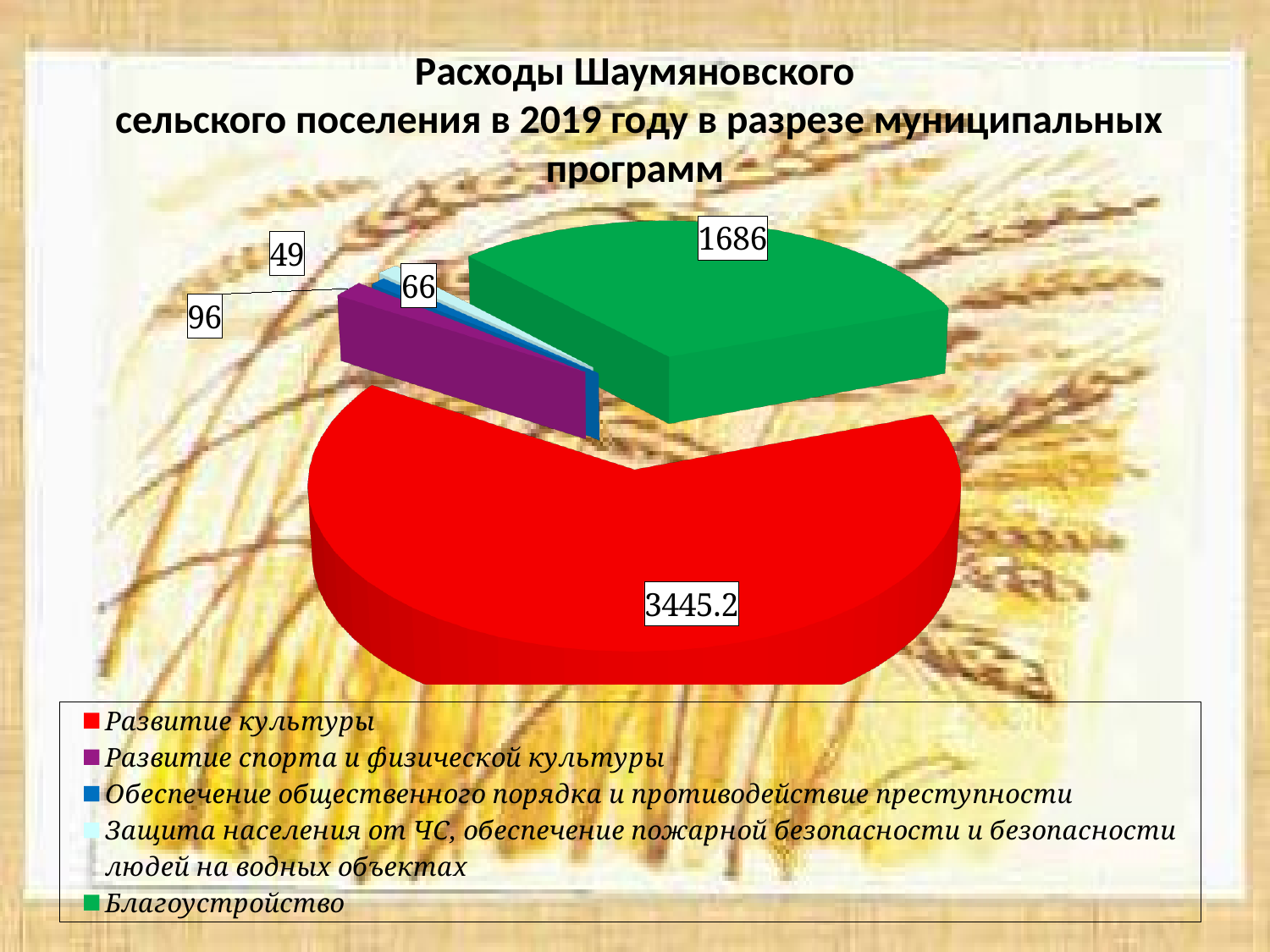
Which is larger, the value for Благоустройство or the value for Развитие спорта и физической культуры? Благоустройство What is the value for Благоустройство? 1686 What is the difference between the values for Развитие культуры and Благоустройство? 1759.2 How many slices does the pie chart have? 5 What colour is the slice for Благоустройство? green What kind of chart is shown on the slide? pie chart Which category has the largest slice of the pie? Развитие культуры What is the difference between the values for Благоустройство and Развитие спорта и физической культуры? 1590 What is the title of the chart? Расходы Шаумяновского сельского поселения в 2019 году в разрезе муниципальных программ What is the smallest value labelled on the chart? 49 What is the value for Развитие культуры? 3445.2 What is the value for Развитие спорта и физической культуры? 96